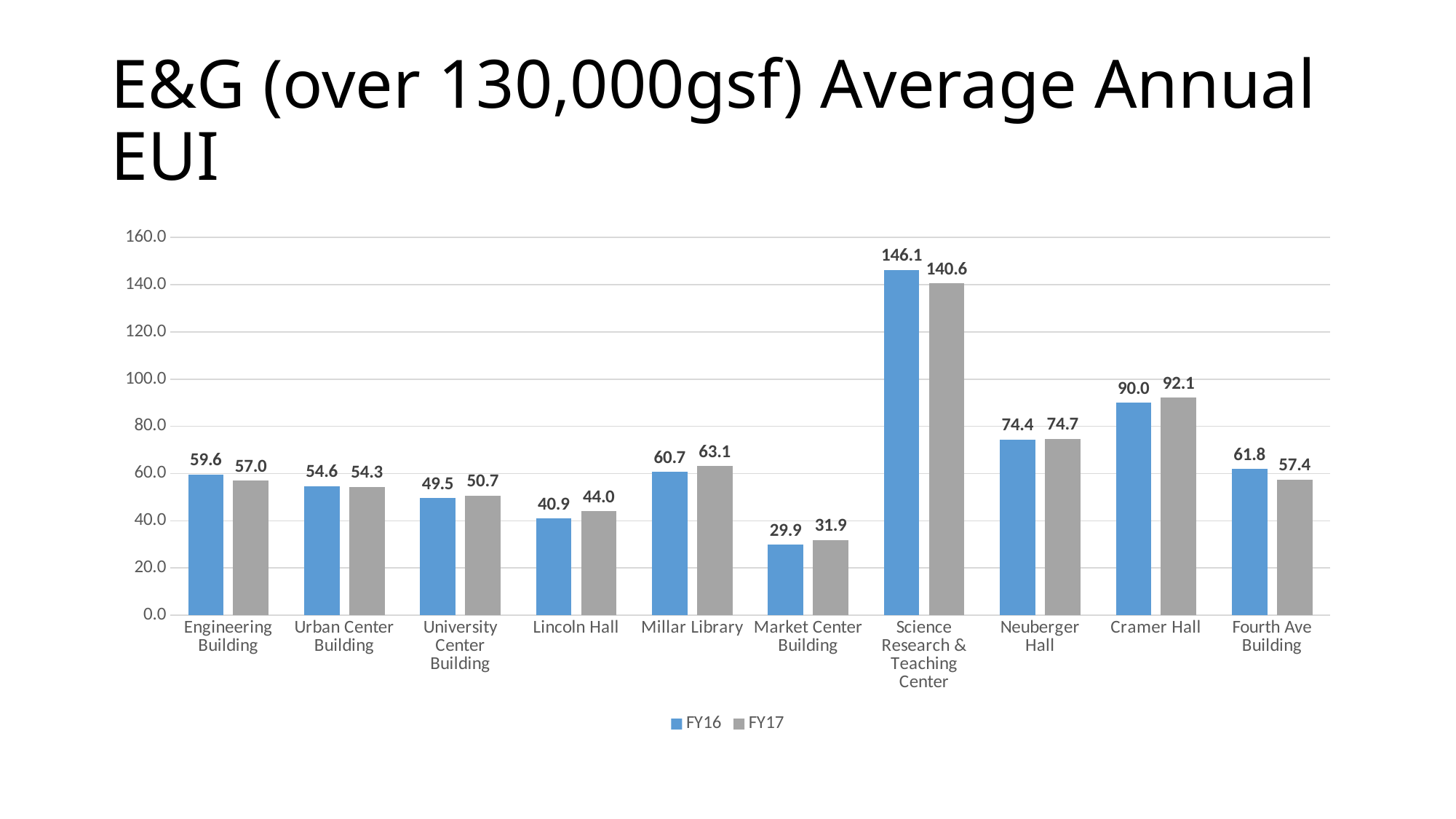
How many series does the legend list? 2 Which is larger, the FY16 value for Millar Library or the FY16 value for Fourth Ave Building? Fourth Ave Building Which building has the lowest FY17 value? Market Center Building What kind of chart is shown on the slide? bar chart What is the FY17 value for Lincoln Hall? 44.0 What is the FY16 value for Cramer Hall? 90.0 What is the difference between the FY17 values for Cramer Hall and Neuberger Hall? 17.4 Which building has the highest FY16 value? Science Research & Teaching Center Is the FY17 value for Neuberger Hall greater or less than 80.0? less How many buildings are shown on the x axis? 10 What is the difference between the FY16 and FY17 values for Science Research & Teaching Center? 5.5 What is the FY17 value for Market Center Building? 31.9